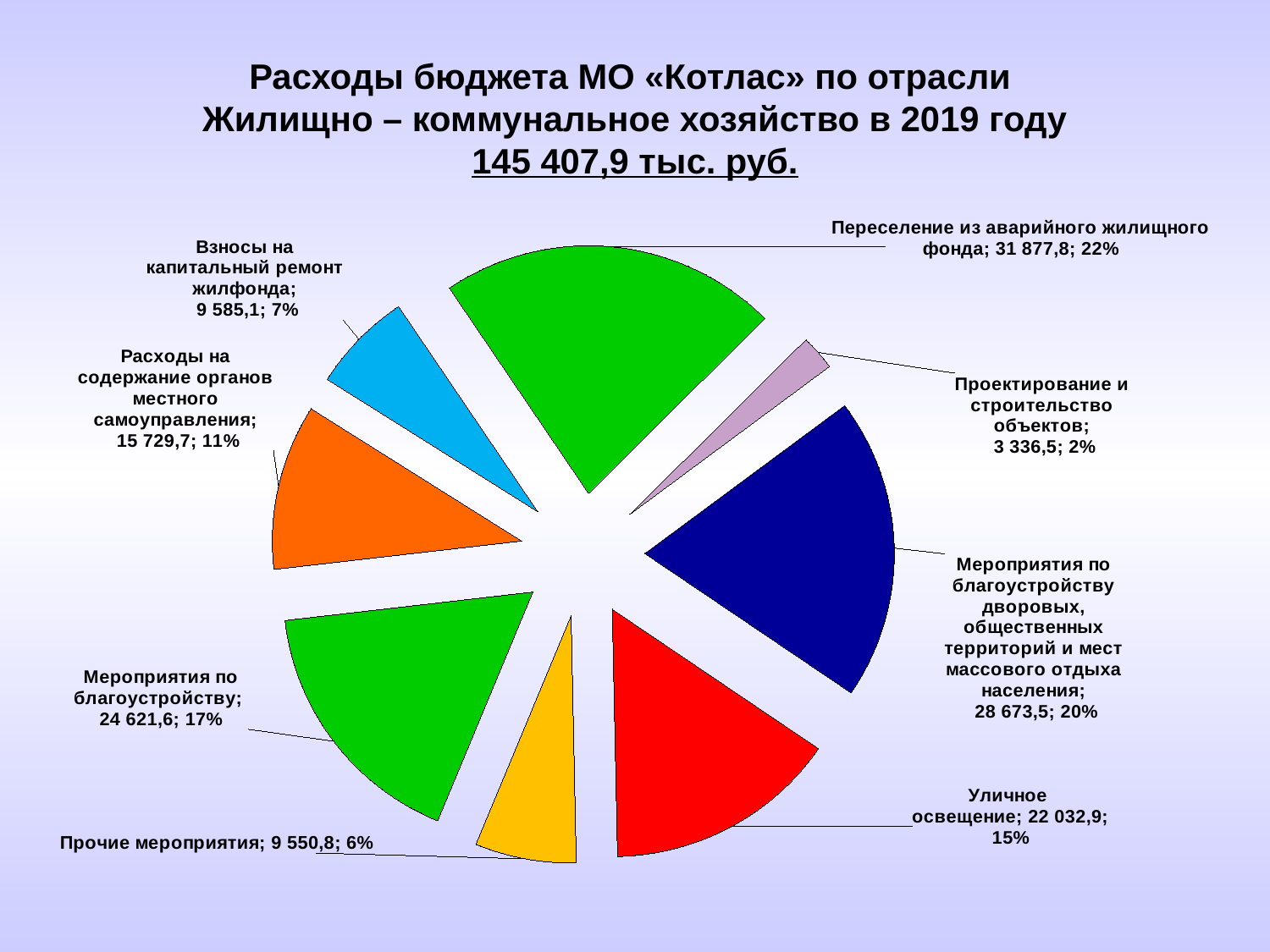
What is the value for «Переселение из аварийного жилищного фонда»? 31 877,8 What is the difference between the values for «Переселение из аварийного жилищного фонда» and «Мероприятия по благоустройству дворовых, общественных территорий и мест массового отдыха населения»? 3 204,3 What kind of chart is shown on the slide? Pie chart Which category has the largest slice of the pie? Переселение из аварийного жилищного фонда How many slices does the pie chart have? 8 Which category has the smallest slice of the pie? Проектирование и строительство объектов What is the value for «Расходы на содержание органов местного самоуправления»? 15 729,7 What is the value for «Уличное освещение»? 22 032,9 Which is larger: the value for «Уличное освещение» or for «Взносы на капитальный ремонт жилфонда»? Уличное освещение What share of the pie does «Мероприятия по благоустройству» represent? 17% What total amount is stated in the chart title? 145 407,9 тыс. руб. What share of the pie does «Прочие мероприятия» represent? 6%